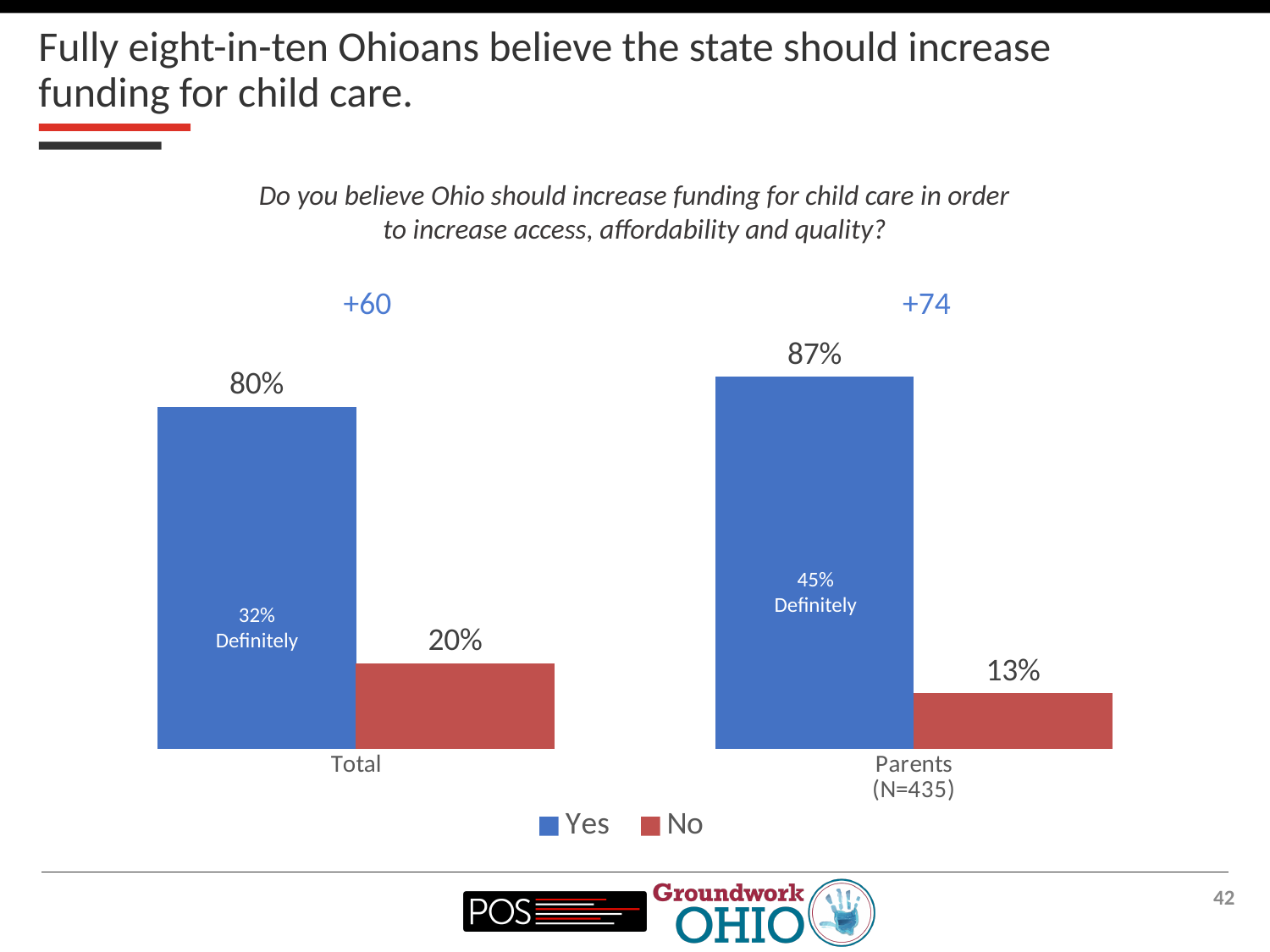
What is the difference between the Yes and No percentages for Parents (N=435)? 74 percentage points What percentage of the Total group answered No? 20% What percentage of the Total group answered Yes? 80% Which group has the lowest No percentage? Parents (N=435) What colour represents the 'No' responses in the chart? Red What percentage of Parents (N=435) answered No? 13% What share of the Total group said 'Definitely' yes? 32% How many series does the legend list? 2 Which group has the higher Yes percentage, Total or Parents (N=435)? Parents (N=435) What share of Parents (N=435) said 'Definitely' yes? 45% What kind of chart is shown on the slide? Bar chart What percentage of Parents (N=435) answered Yes? 87%